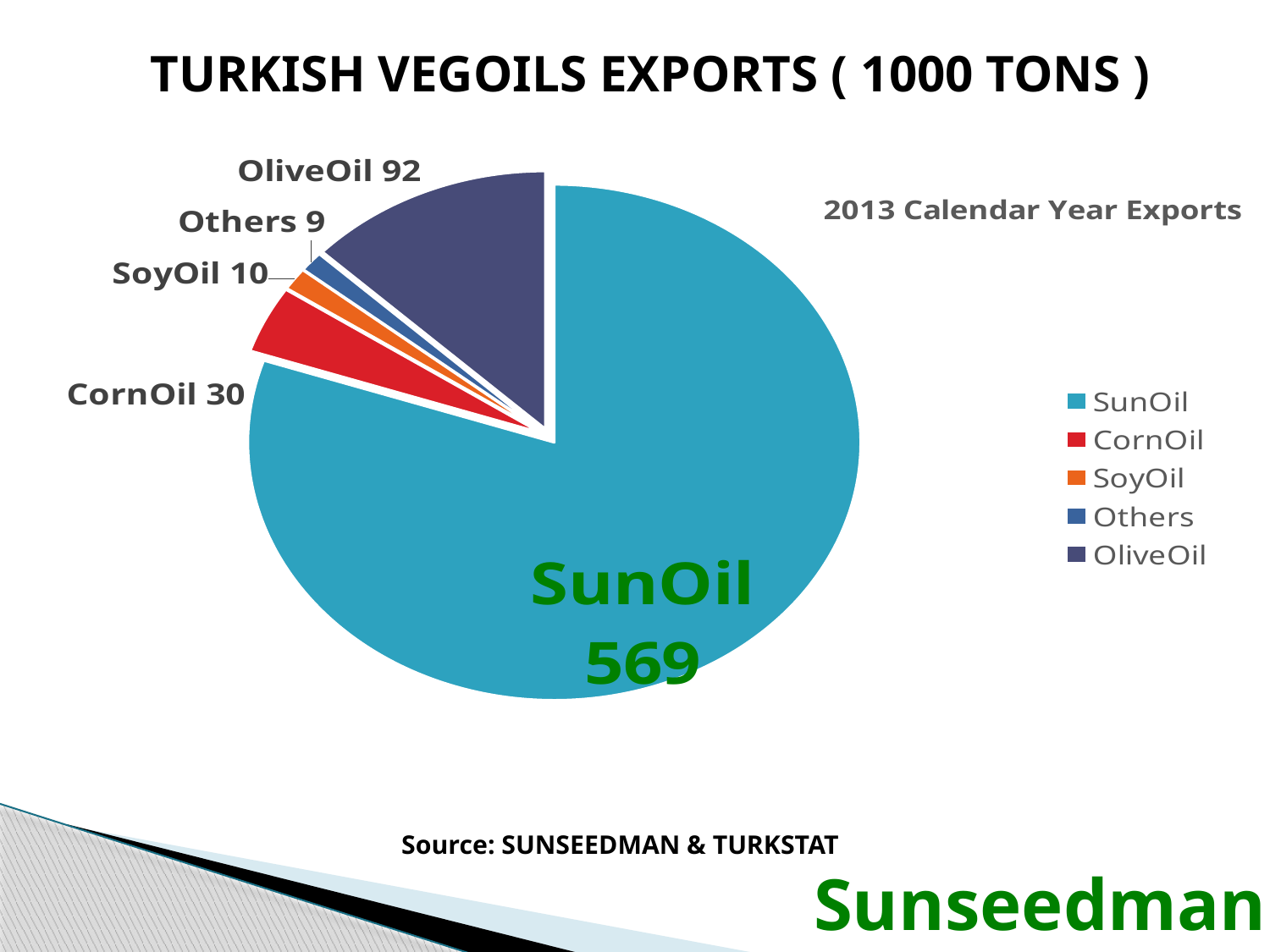
Which category has the smallest slice of the pie chart? Others Which is larger, the value for CornOil or the value for SoyOil? CornOil What is the value for OliveOil in the pie chart? 92 What is the value for Others in the pie chart? 9 What is the title of the chart on the slide? 2013 Calendar Year Exports What type of chart is shown on the slide? Pie chart How many categories does the legend of the pie chart list? 5 Which category has the largest slice of the pie chart? SunOil What is the difference between the SunOil and OliveOil values? 477 What is the value for SoyOil in the pie chart? 10 What is the value for SunOil in the pie chart? 569 What is the value for CornOil in the pie chart? 30